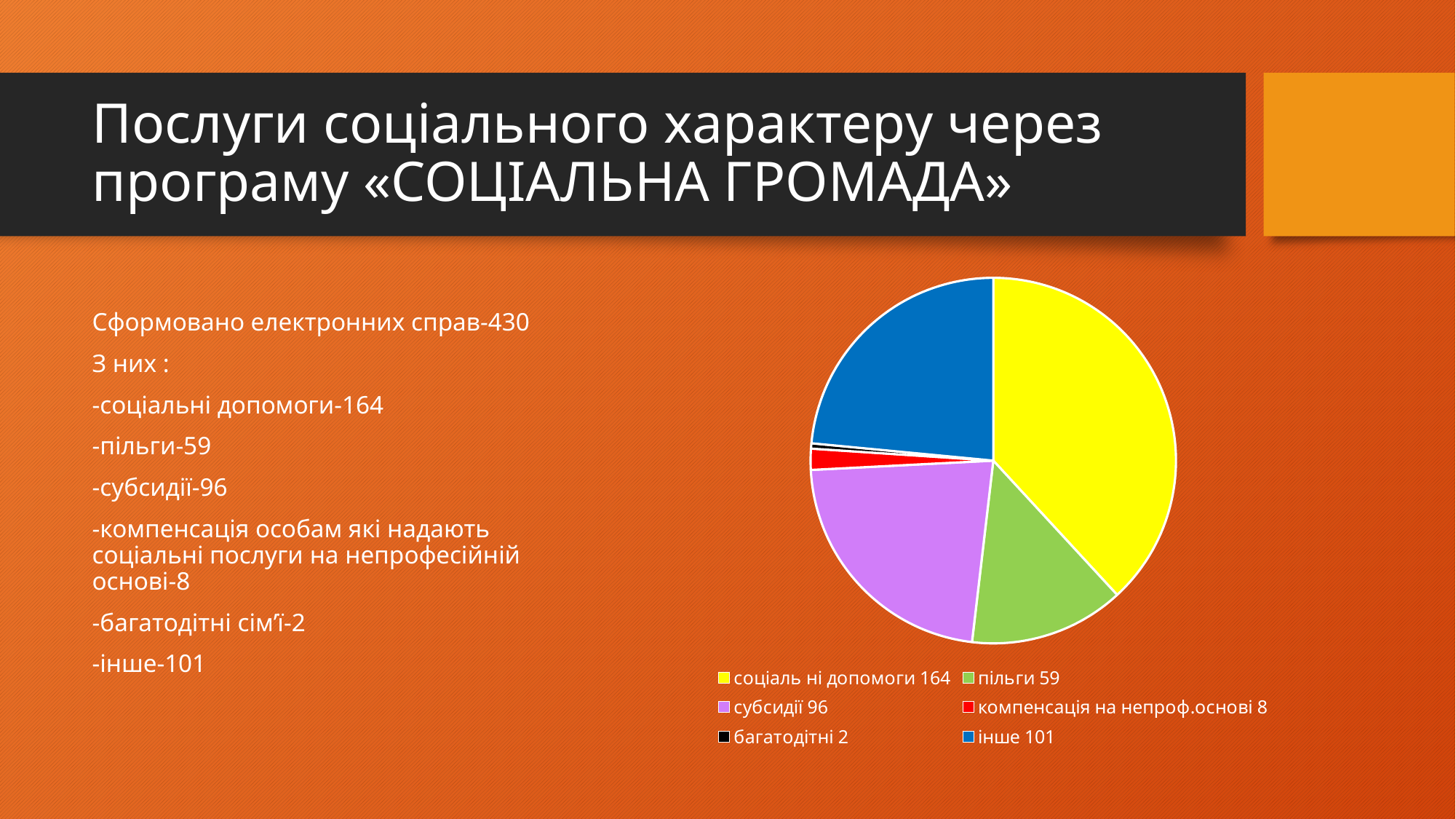
How many slices does the pie chart have? 6 What is the difference between the values for інше and пільги? 42 What is the total of all slices in the pie chart? 430 Which category has the smallest slice in the pie chart? багатодітні What kind of chart is shown on the slide? pie chart What is the difference between the values for соціальні допомоги and субсидії? 68 Which is larger, the value for інше or the value for субсидії? інше Which category has the largest slice in the pie chart? соціальні допомоги What colour is the slice for соціальні допомоги? yellow What is the value for інше in the pie chart? 101 What is the value for компенсація на непроф.основі in the pie chart? 8 What is the value for субсидії in the pie chart? 96